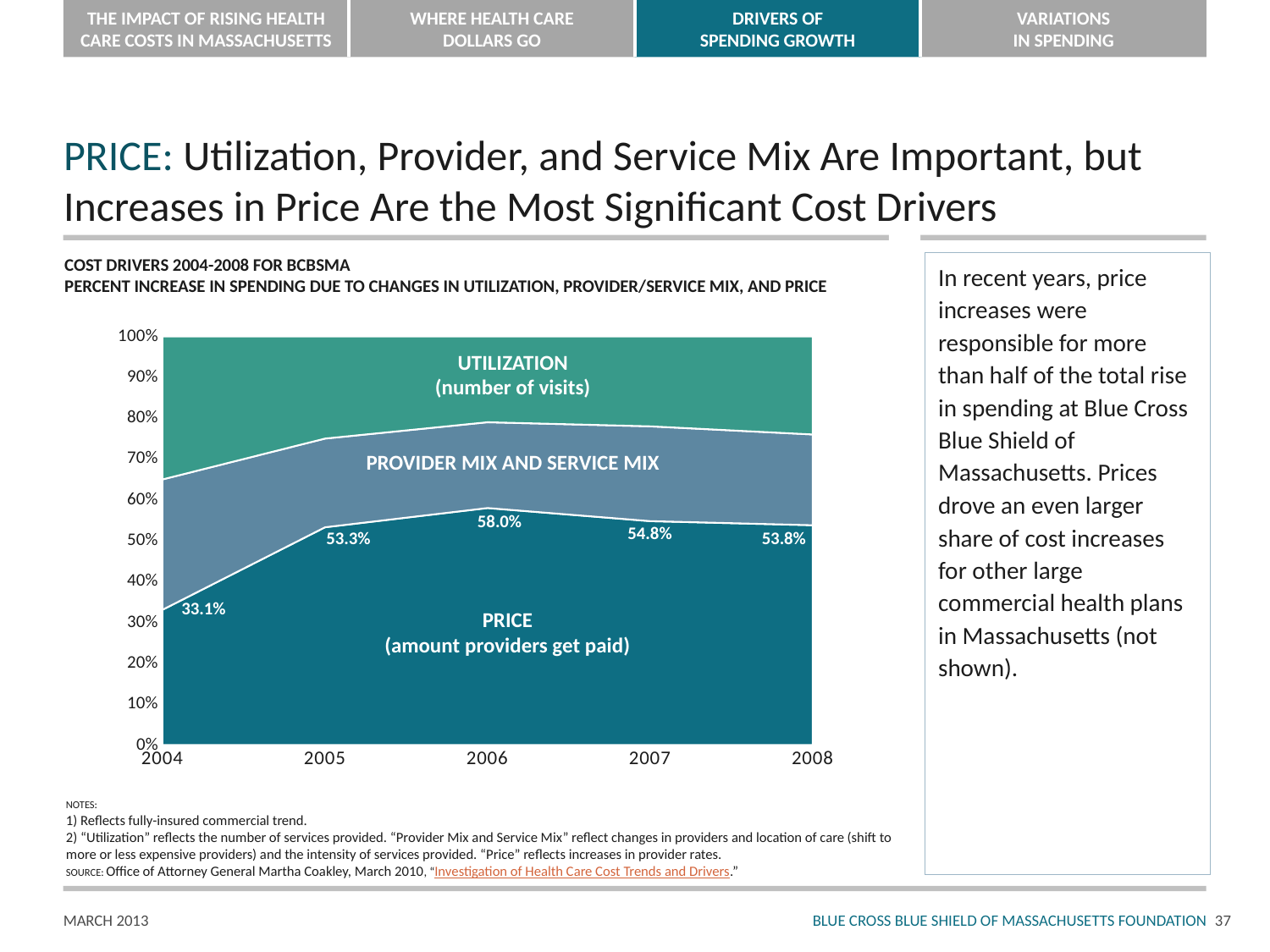
What share of the spending increase was due to Price in 2006? 58.0% How many years are shown on the x axis of the chart? 5 In which year was the Price share of the spending increase lowest? 2004 By how many percentage points did the Price share change from 2004 to 2005? 20.2 percentage points Was the Price share in 2004 greater or less than 40%? less Which year had a larger Price share: 2005 or 2007? 2007 What share of the spending increase was due to Price in 2007? 54.8% What kind of chart is shown on the slide? Stacked area chart In which year was the Price share of the spending increase highest? 2006 What share of the spending increase was due to Price in 2004? 33.1% What share of the spending increase was due to Price in 2008? 53.8% How many cost-driver components are stacked in the chart? 3